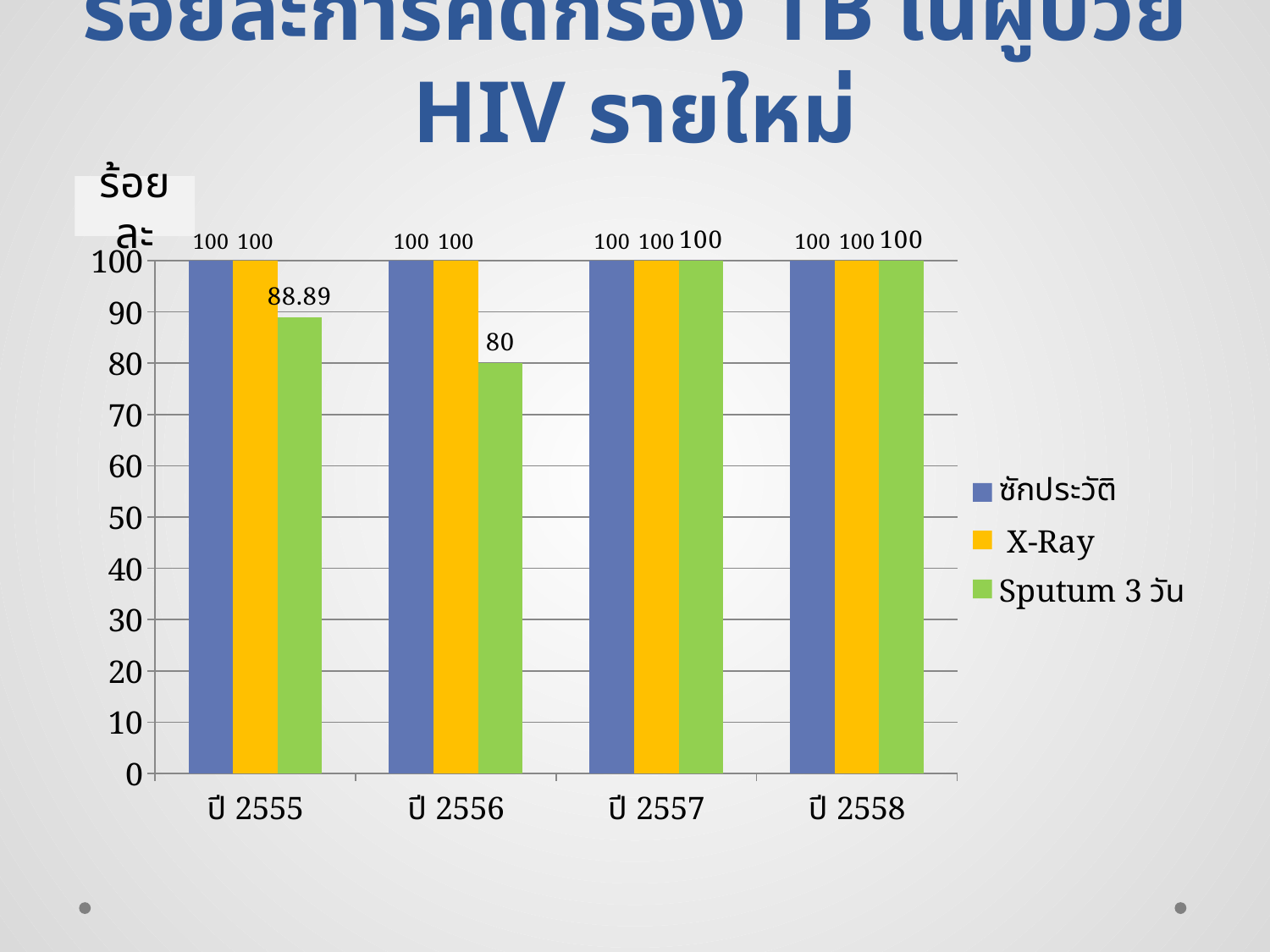
What is the difference between the X-Ray value and the Sputum 3 วัน value in ปี 2556? 20 What kind of chart is shown on the slide? Bar chart What is the value for X-Ray in ปี 2557? 100 What is the value for Sputum 3 วัน in ปี 2555? 88.89 In which year is the Sputum 3 วัน value lowest? ปี 2556 Which is larger in ปี 2555: the ซักประวัติ value or the Sputum 3 วัน value? ซักประวัติ What is the difference between the Sputum 3 วัน values in ปี 2555 and ปี 2556? 8.89 What is the value for ซักประวัติ in ปี 2558? 100 How many years (categories) are shown on the x axis? 4 How many series does the legend list? 3 What is the value for Sputum 3 วัน in ปี 2556? 80 Which series is shown in green in the legend? Sputum 3 วัน